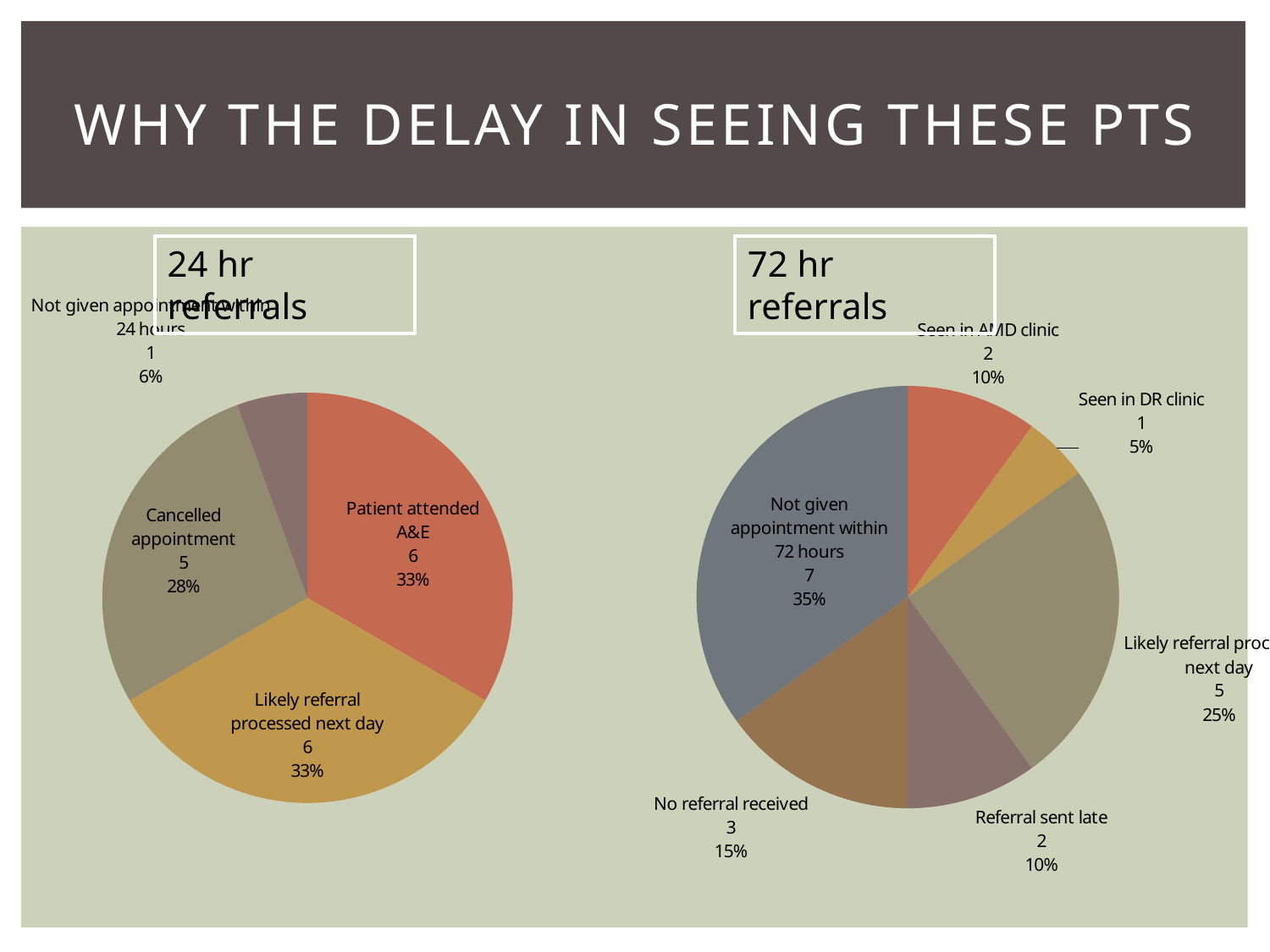
What is the title of the pie chart on the right of the slide? 72 hr referrals In the 24 hr referrals chart, what share of the pie is Cancelled appointment? 28% How many slices does the 72 hr referrals pie chart have? 6 In the 72 hr referrals chart, which is larger: Referral sent late or No referral received? No referral received In the 72 hr referrals chart, what share of the pie is No referral received? 15% In the 72 hr referrals chart, which category has the largest slice? Not given appointment within 72 hours In the 24 hr referrals chart, which category has the smallest slice? Not given appointment within 24 hours In the 72 hr referrals chart, how many patients were Seen in DR clinic? 1 What kind of chart is the 24 hr referrals chart? pie chart How many slices does the 24 hr referrals pie chart have? 4 In the 24 hr referrals chart, what is the difference between the Cancelled appointment count and the Not given appointment within 24 hours count? 4 In the 24 hr referrals chart, how many patients attended A&E? 6